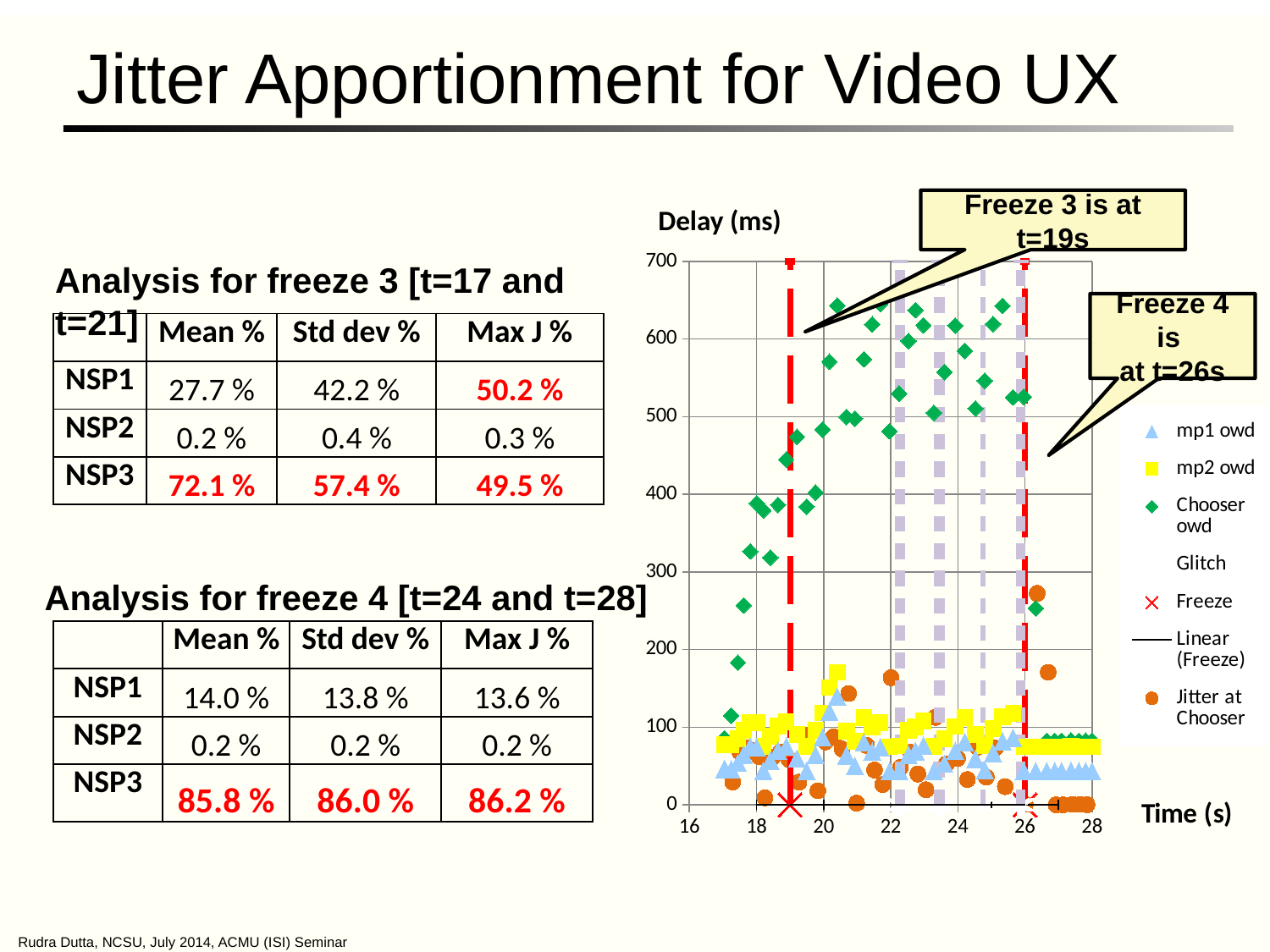
At t=22, which is larger: the Chooser owd value or the mp2 owd value? Chooser owd What is the label on the horizontal axis of the chart? Time (s) Which series in the chart reaches the highest delay values? Chooser owd Are the Chooser owd values between t=22 and t=25 greater or less than 400 ms? greater What is the label on the vertical axis of the chart? Delay (ms) What is the maximum value shown on the Delay (ms) axis? 700 How many series does the chart legend list? 7 According to the callout on the chart, at what time is Freeze 3? t=19s Are the mp2 owd values in the chart greater or less than 300 ms? less What kind of chart is shown on the slide? scatter chart Between t=17 and t=20, do the Chooser owd values rise or fall? rise According to the callout on the chart, at what time is Freeze 4? t=26s